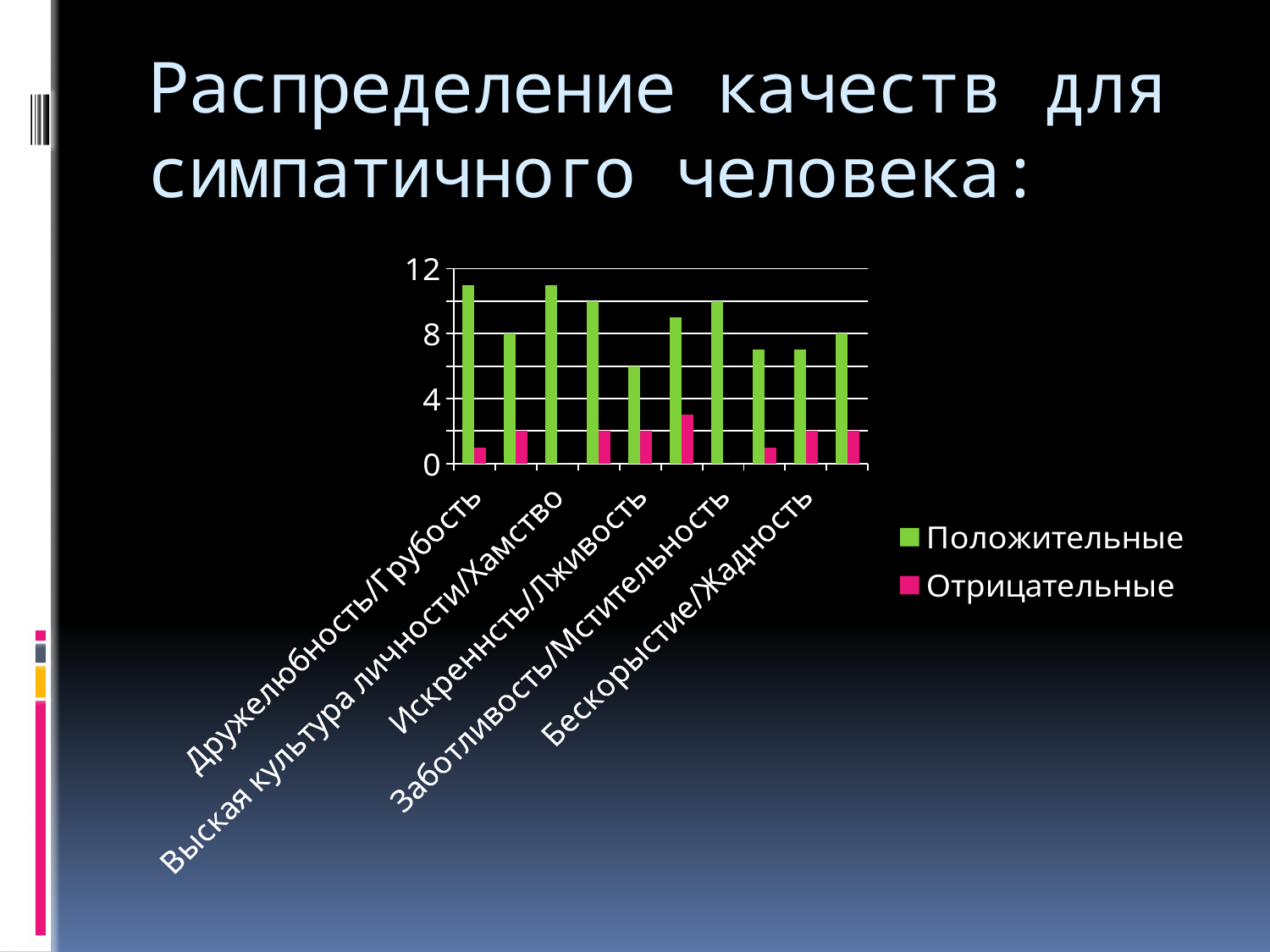
Is the Положительные value for Дружелюбность/Грубость greater or less than 8? greater Is the Положительные value for Бескорыстие/Жадность greater or less than 8? less For Дружелюбность/Грубость, which series has the larger value, Положительные or Отрицательные? Положительные Which series is shown in green in the legend? Положительные Is the Положительные value for Заботливость/Мстительность greater or less than 8? greater Which series is shown in pink in the legend? Отрицательные How many categories are plotted in the chart? 10 How many series does the legend list? 2 What kind of chart is shown on the slide? bar chart